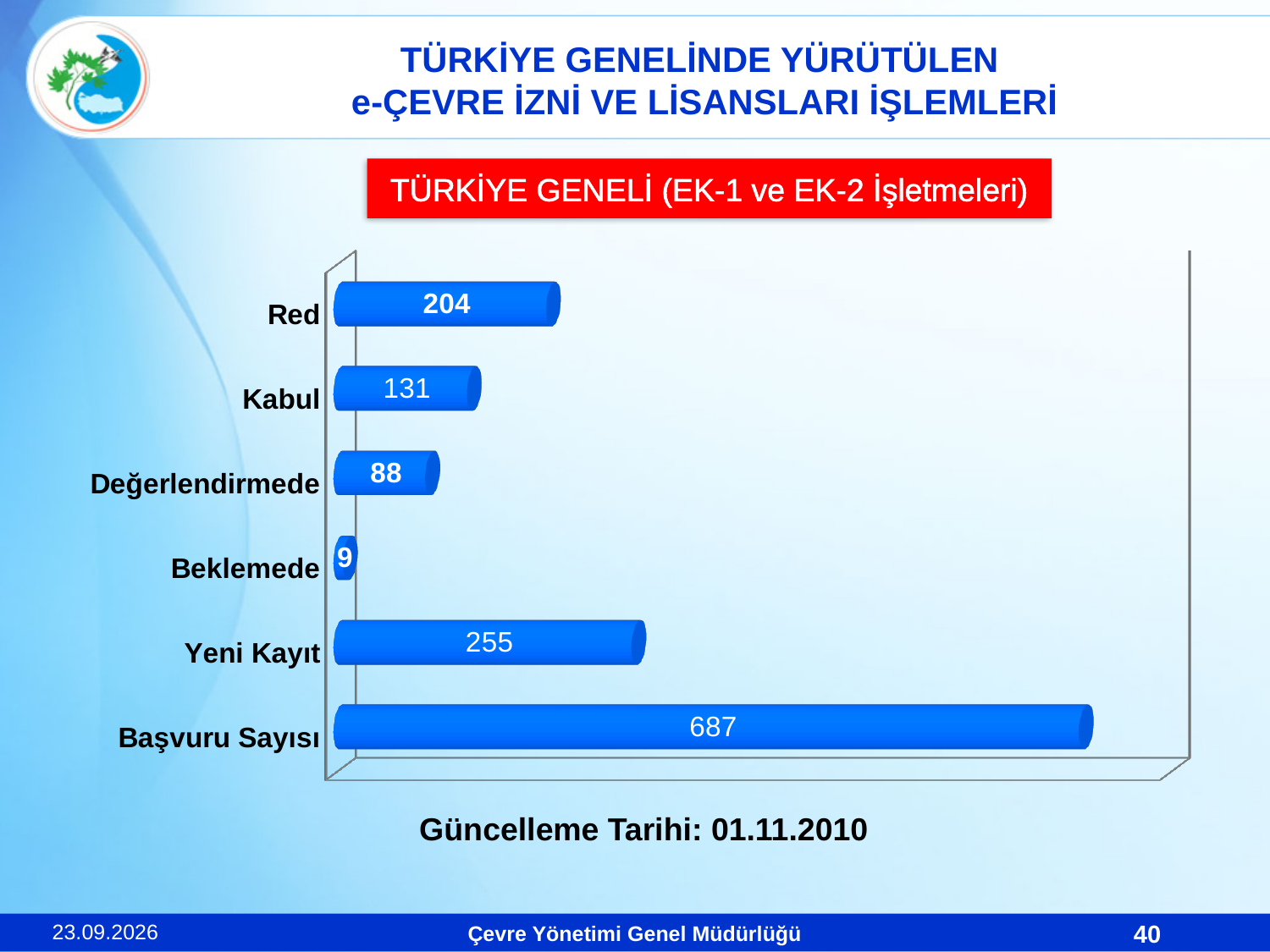
What is the value for Beklemede? 9 What is the value for Kabul? 131 What is the difference between the values for Red and Kabul? 73 What is the value for Yeni Kayıt? 255 Which is larger, the value for Yeni Kayıt or the value for Red? Yeni Kayıt What is the value for Başvuru Sayısı? 687 What is the value for Değerlendirmede? 88 Which category has the highest value? Başvuru Sayısı Which category has the lowest value? Beklemede What kind of chart is shown on the slide? Bar chart What is the value for Red? 204 How many categories are shown in the chart? 6